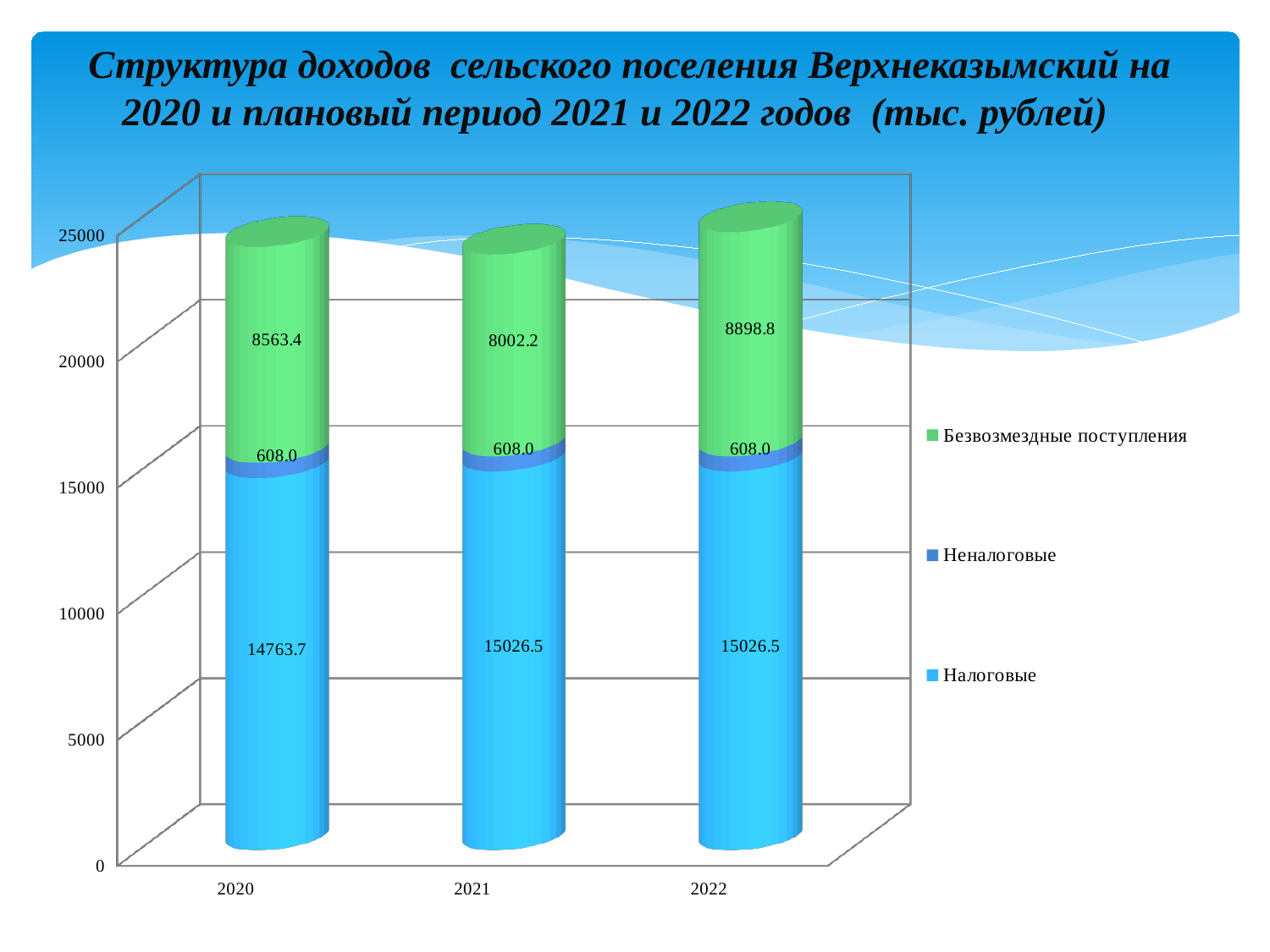
Which is larger: Налоговые in 2020 or Налоговые in 2021? Налоговые in 2021 What is the total of the stacked bar for 2022? 24533.3 In which year is Безвозмездные поступления the highest? 2022 What type of chart is shown on the slide? stacked bar chart In which year is Безвозмездные поступления the lowest? 2021 How many series does the legend list? 3 What is the value of Безвозмездные поступления for 2021? 8002.2 Which series is shown in green in the legend? Безвозмездные поступления What is the value of Налоговые for 2020? 14763.7 What is the value of Неналоговые for 2022? 608.0 How many years (categories) are shown on the x axis? 3 What is the difference between Безвозмездные поступления in 2022 and in 2021? 896.6